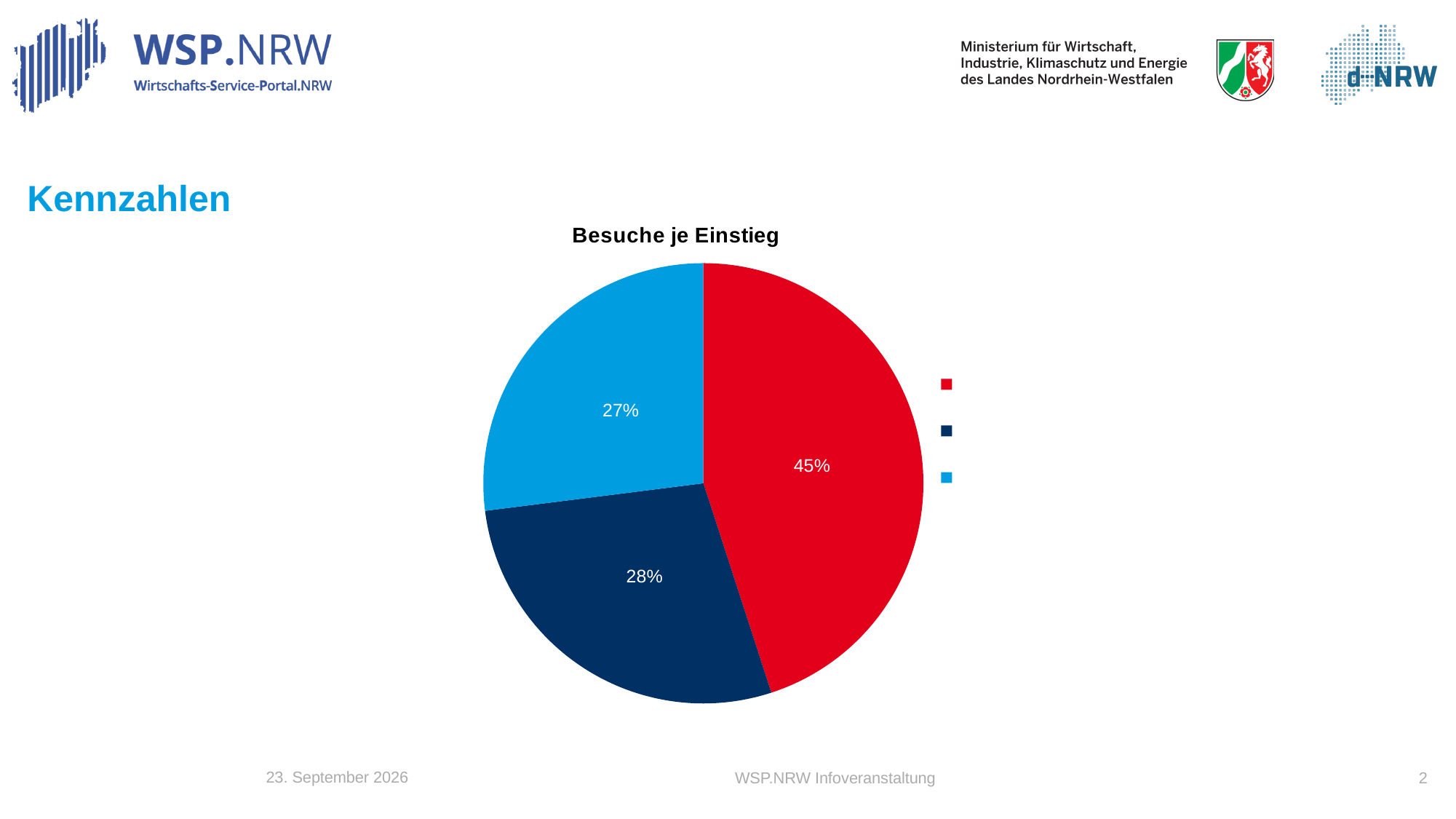
What is the title of the chart? Besuche je Einstieg What share of the pie does the light blue slice represent? 27% What share of the pie does the dark blue slice represent? 28% What share of the pie does the red slice represent? 45% Which is larger, the red slice or the light blue slice? red slice How many entries does the legend list? 3 Which colour slice is the smallest in the pie chart? light blue How many slices does the pie chart have? 3 What is the difference in percentage points between the red slice and the dark blue slice? 17 What kind of chart is shown on the slide? pie chart What is the difference in percentage points between the dark blue slice and the light blue slice? 1 Which colour slice is the largest in the pie chart? red